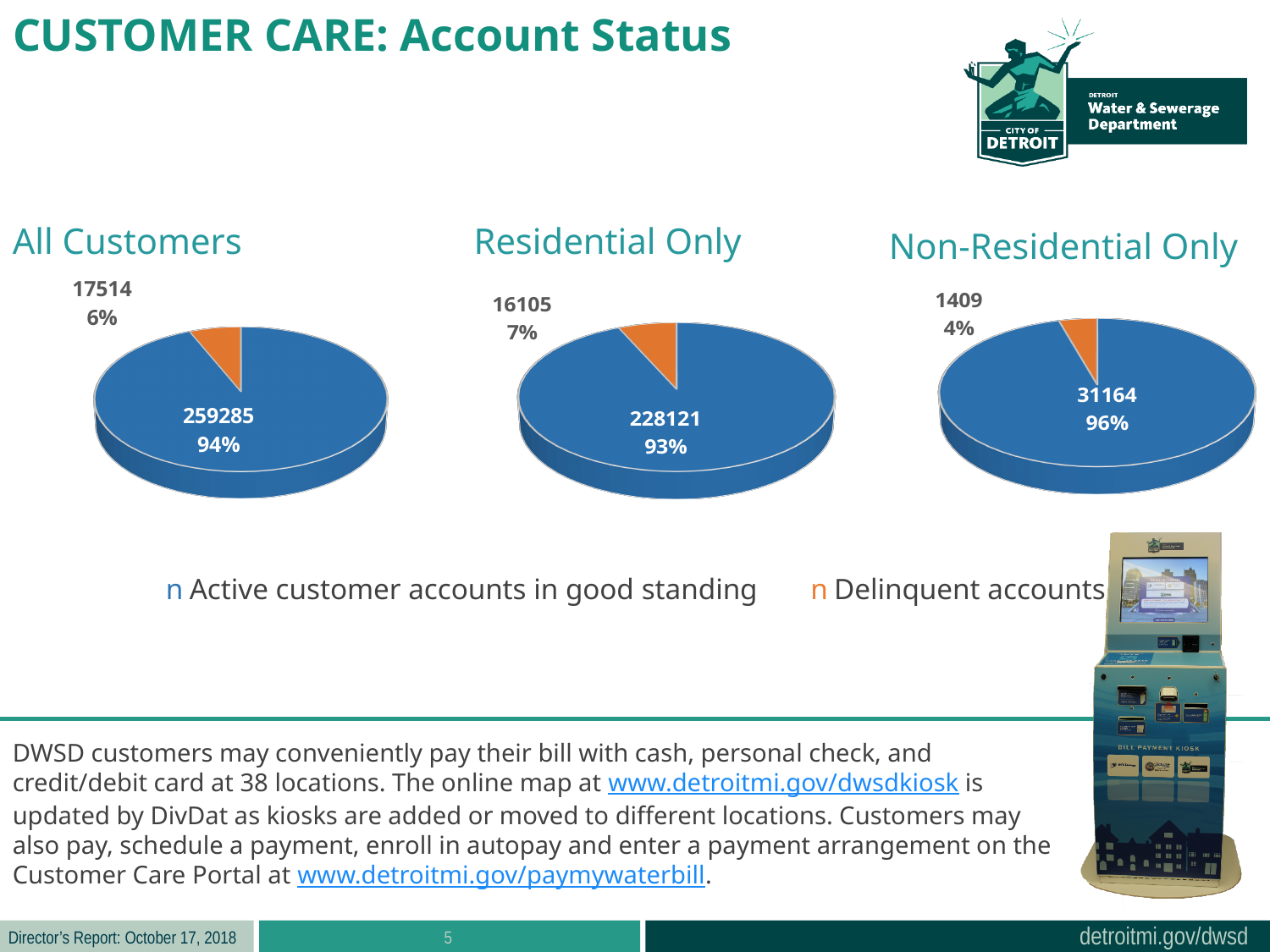
How many categories does the shared legend list for the pie charts? 2 In the All Customers chart, what share of accounts are delinquent? 6% In the Residential Only chart, what share of accounts are active customer accounts in good standing? 93% In the Residential Only chart, how many delinquent accounts are there? 16105 How many slices does the Residential Only pie chart have? 2 In the Non-Residential Only chart, what is the total number of accounts shown across both slices? 32573 In the Residential Only chart, what is the difference between the number of accounts in good standing and the number of delinquent accounts? 212016 What kind of chart is used for the All Customers data? Pie chart In the Non-Residential Only chart, what share of accounts are active customer accounts in good standing? 96% In the Non-Residential Only chart, how many delinquent accounts are there? 1409 In the All Customers chart, how many active customer accounts are in good standing? 259285 In the All Customers chart, which slice is larger: active customer accounts in good standing or delinquent accounts? Active customer accounts in good standing